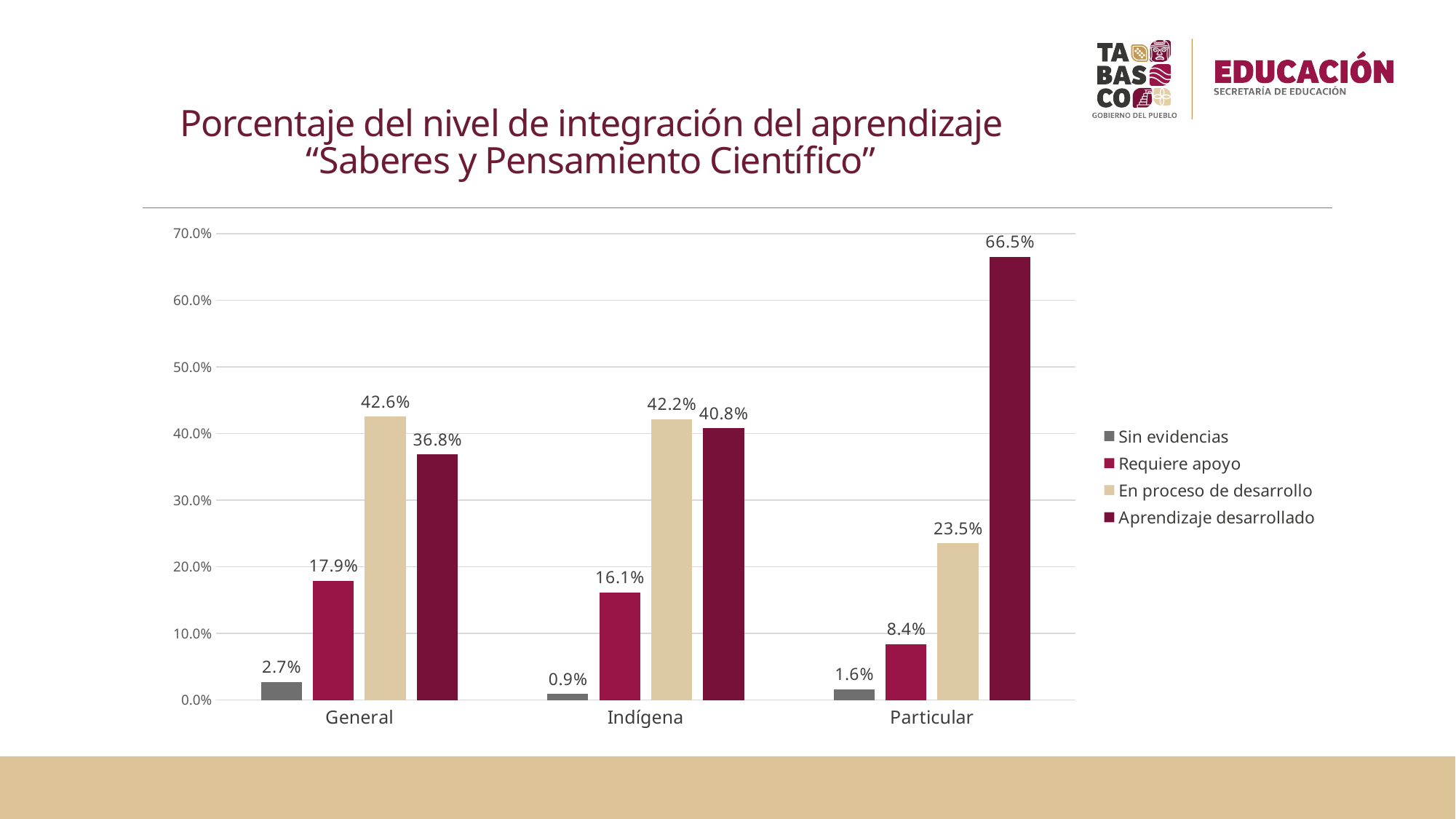
What is the value for "Aprendizaje desarrollado" in the Particular category? 66.5% What is the value for "Requiere apoyo" in the Particular category? 8.4% What is the difference between "En proceso de desarrollo" and "Aprendizaje desarrollado" in the General category? 5.8% What is the value for "En proceso de desarrollo" in the General category? 42.6% Which legend entry is shown in grey? Sin evidencias How many series does the legend list? 4 Which category has the highest value for "Aprendizaje desarrollado"? Particular What is the value for "Sin evidencias" in the Indígena category? 0.9% What kind of chart is shown on the slide? Bar chart Which is larger in the Indígena category: "Requiere apoyo" or "En proceso de desarrollo"? En proceso de desarrollo How many categories are shown on the x axis? 3 Which category has the lowest value for "En proceso de desarrollo"? Particular